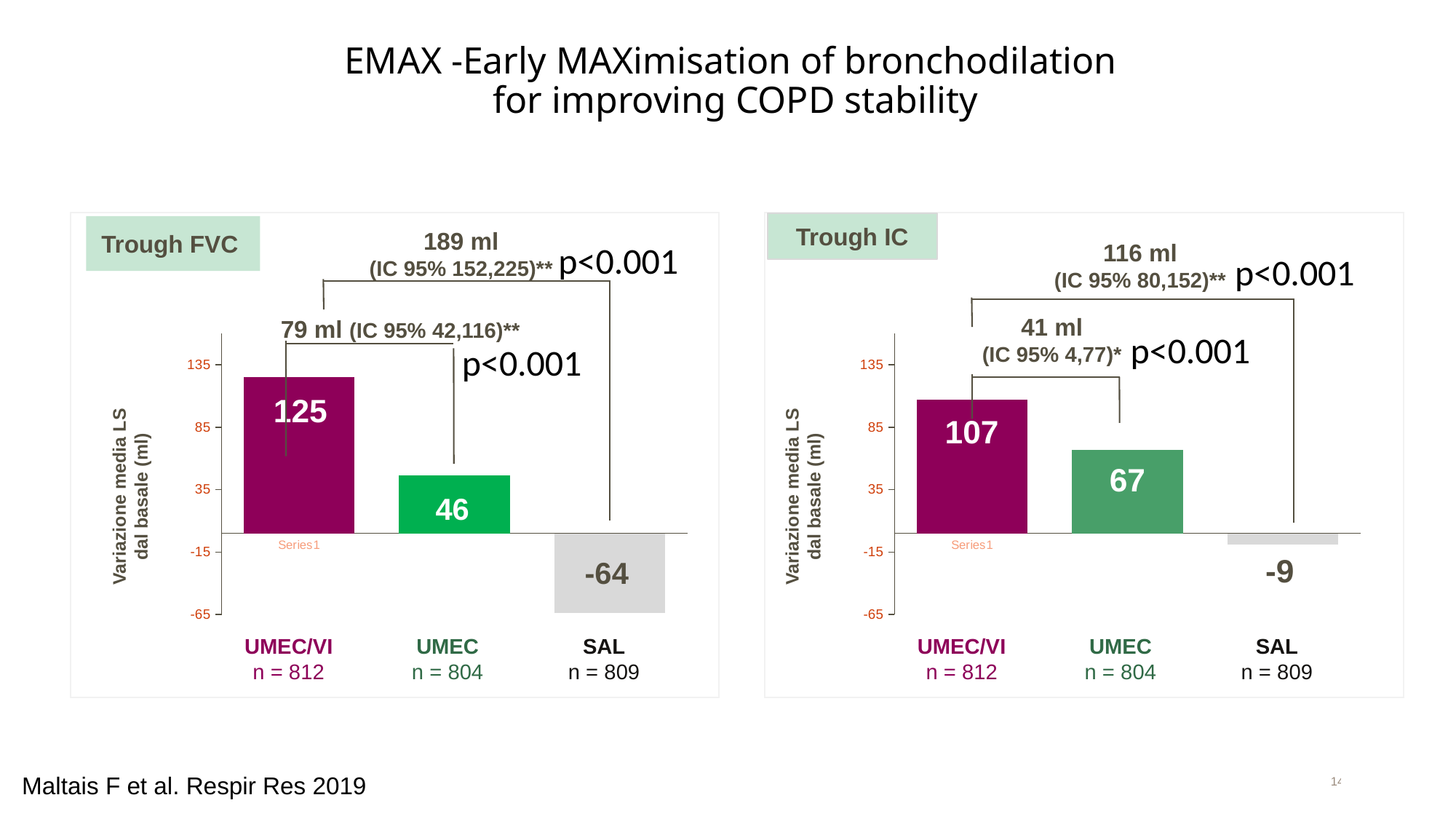
How many treatment categories are shown in the Trough FVC chart? 3 In the Trough FVC chart, what is the y-axis label? Variazione media LS dal basale (ml) In the Trough IC chart, which treatment has the lowest value? SAL In the Trough IC chart, what is the difference between the UMEC/VI value and the SAL value? 116 What type of chart is the Trough IC chart? Bar chart In the Trough IC chart, which is larger, the value for UMEC/VI or the value for UMEC? UMEC/VI In the Trough FVC chart, what is the difference between the UMEC/VI value and the UMEC value? 79 In the Trough FVC chart, which treatment has the highest value? UMEC/VI In the Trough IC chart, what is the value for SAL? -9 In the Trough FVC chart, what is the value for UMEC/VI? 125 In the Trough FVC chart, what is the value for SAL? -64 In the Trough IC chart, what is the value for UMEC? 67